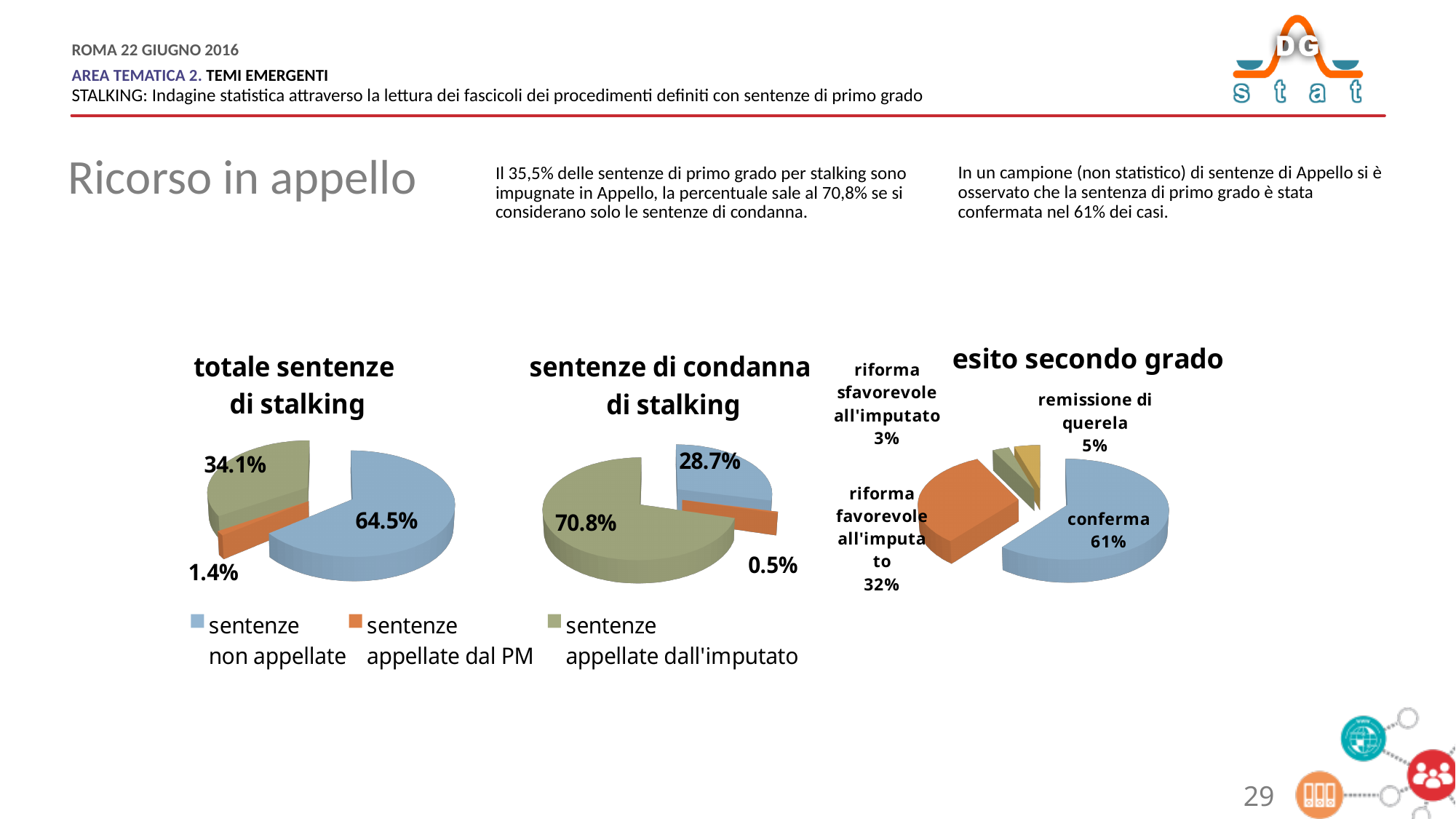
In the 'sentenze di condanna di stalking' chart, which category has the smallest slice? sentenze appellate dal PM In the 'totale sentenze di stalking' chart, what share is labelled for sentenze non appellate? 64.5% In the 'esito secondo grado' chart, what share is labelled for riforma favorevole all'imputato? 32% In the 'esito secondo grado' chart, what share is labelled for conferma? 61% How many slices does the 'esito secondo grado' chart have? 4 In the 'totale sentenze di stalking' chart, which category has the largest slice? sentenze non appellate In the 'totale sentenze di stalking' chart, what share is labelled for sentenze appellate dal PM? 1.4% How many entries does the legend below the first two charts list? 3 In the 'esito secondo grado' chart, which is larger: remissione di querela or riforma sfavorevole all'imputato? remissione di querela What kind of chart is 'totale sentenze di stalking'? pie chart In the 'sentenze di condanna di stalking' chart, what share is labelled for sentenze appellate dall'imputato? 70.8% In the 'sentenze di condanna di stalking' chart, what is the difference between the shares for sentenze appellate dall'imputato and sentenze non appellate? 42.1 percentage points